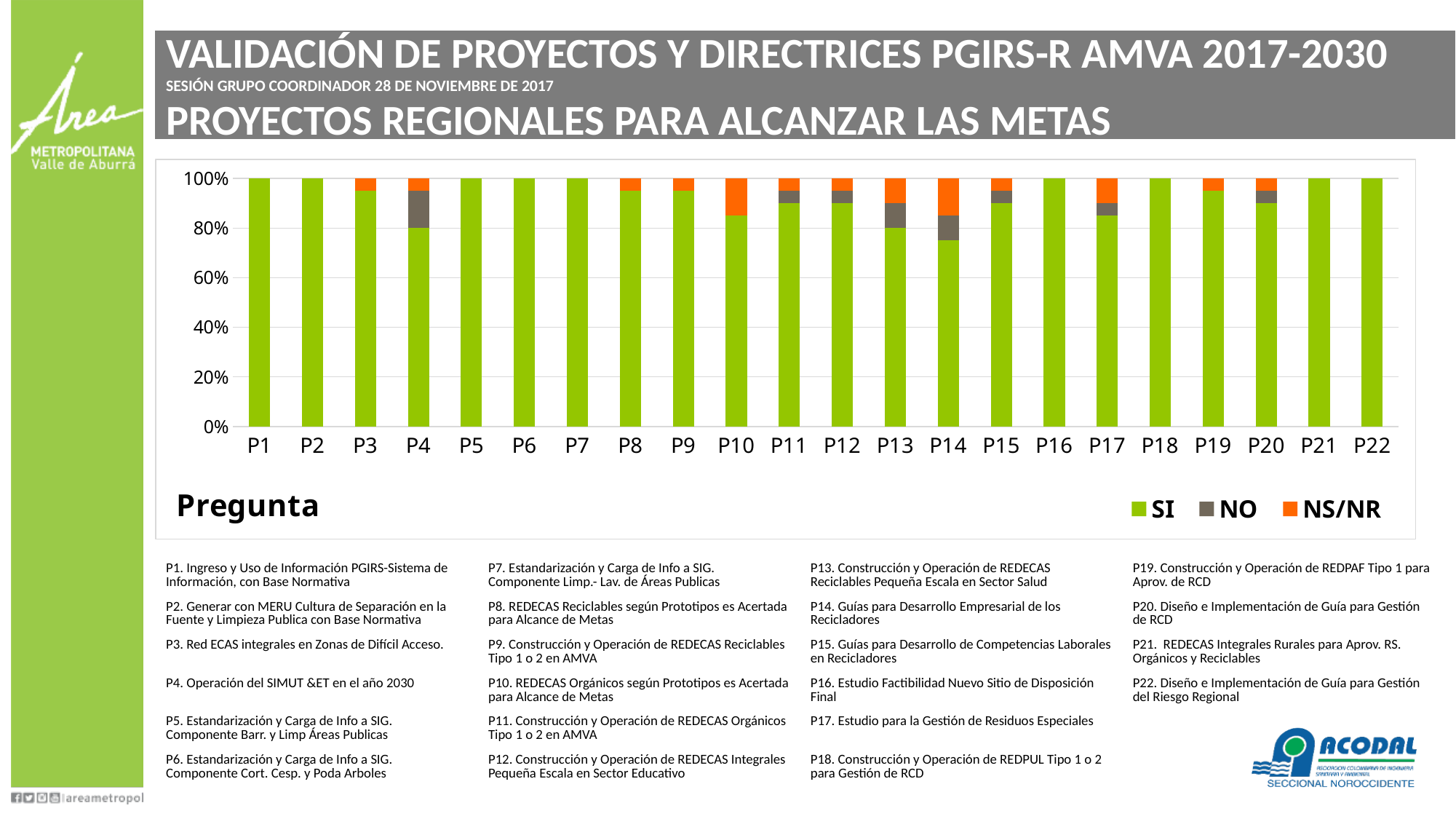
What is the total of the stacked bar for P1? 100% Is the SI value for P10 greater or less than 80%? greater How many questions (P1 to P22) are plotted along the x axis of the chart? 22 Which has the larger SI share, P10 or P14? P10 Which question has the lowest SI share in the chart? P14 What are the three series listed in the chart legend? SI, NO, NS/NR What kind of chart is shown on the slide? Stacked bar chart Is the SI value for P4 greater or less than 90%? less How many series does the chart legend list? 3 What is the label shown for the x axis of the chart? Pregunta Which has the larger NO share, P4 or P11? P4 Is the SI value for P14 greater or less than 80%? less